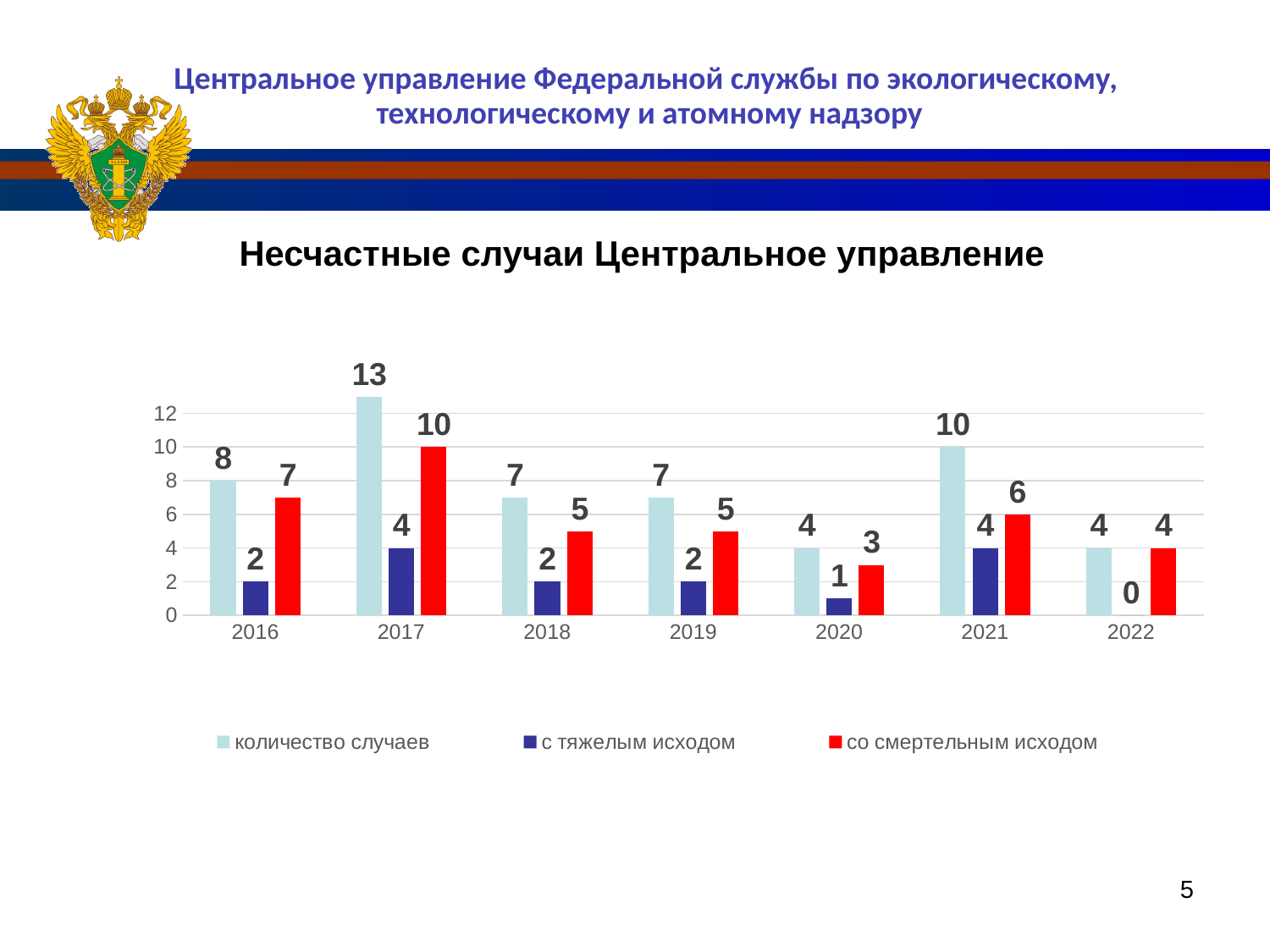
Does "количество случаев" rise or fall from 2017 to 2020? fall What is the value of "количество случаев" for 2017? 13 What is the value of "со смертельным исходом" for 2020? 3 What is the difference between "количество случаев" and "со смертельным исходом" in 2017? 3 How many years are shown on the x axis? 7 What is the value of "с тяжелым исходом" for 2022? 0 How many series does the legend list? 3 Which year has the highest value for "количество случаев"? 2017 Which year has the lowest value for "с тяжелым исходом"? 2022 What is the title of the chart? Несчастные случаи Центральное управление What kind of chart is shown on the slide? bar chart Which is larger: "со смертельным исходом" in 2021 or in 2019? 2021